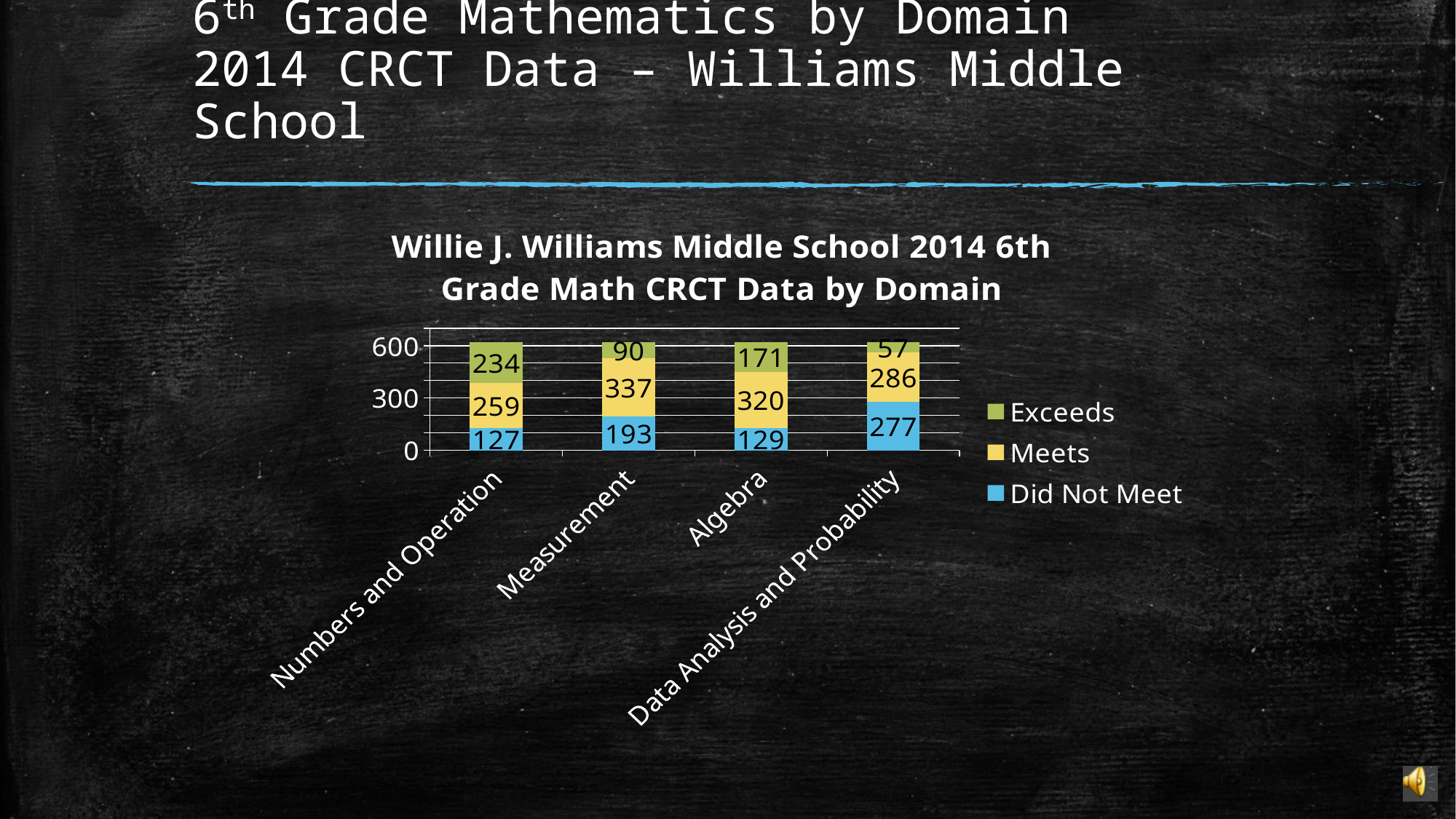
How many domain categories are plotted on the x axis? 4 What is the difference between the Meets values for Measurement and Numbers and Operation? 78 What is the Did Not Meet value for Measurement? 193 What kind of chart is shown on the slide? stacked bar chart Which is larger, the Did Not Meet value for Data Analysis and Probability or the Did Not Meet value for Algebra? Data Analysis and Probability How many series does the legend list? 3 What is the total of the stacked bar for Algebra? 620 What is the Exceeds value for Data Analysis and Probability? 57 What is the Meets value for Algebra? 320 Which series is shown in blue in the legend? Did Not Meet Which domain has the highest Exceeds value? Numbers and Operation Which domain has the lowest Did Not Meet value? Numbers and Operation